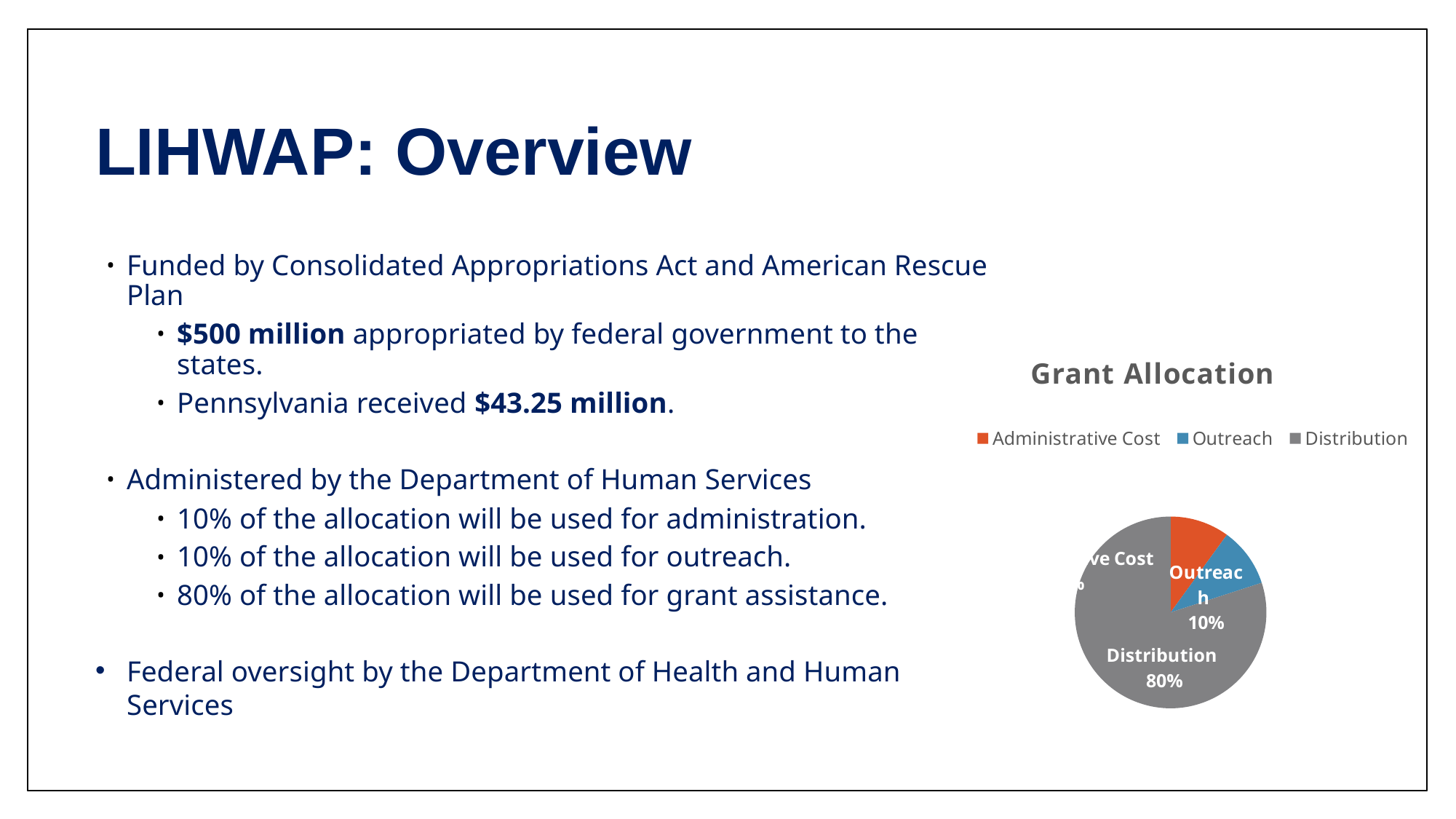
What kind of chart is shown on the slide? Pie chart In the Grant Allocation chart, which is larger: Distribution or Outreach? Distribution How many entries does the legend of the Grant Allocation chart list? 3 Which category has the largest slice in the Grant Allocation pie chart? Distribution What share of the Grant Allocation pie does the Distribution slice take? 80% What colour is the Distribution slice in the Grant Allocation pie chart? Gray How many slices does the Grant Allocation pie chart have? 3 What percentage of the Grant Allocation pie is labelled for Distribution? 80% What is the title of the chart on the slide? Grant Allocation In the Grant Allocation chart, how many percentage points larger is Distribution than Outreach? 70 percentage points What percentage of the Grant Allocation pie is labelled for Outreach? 10%